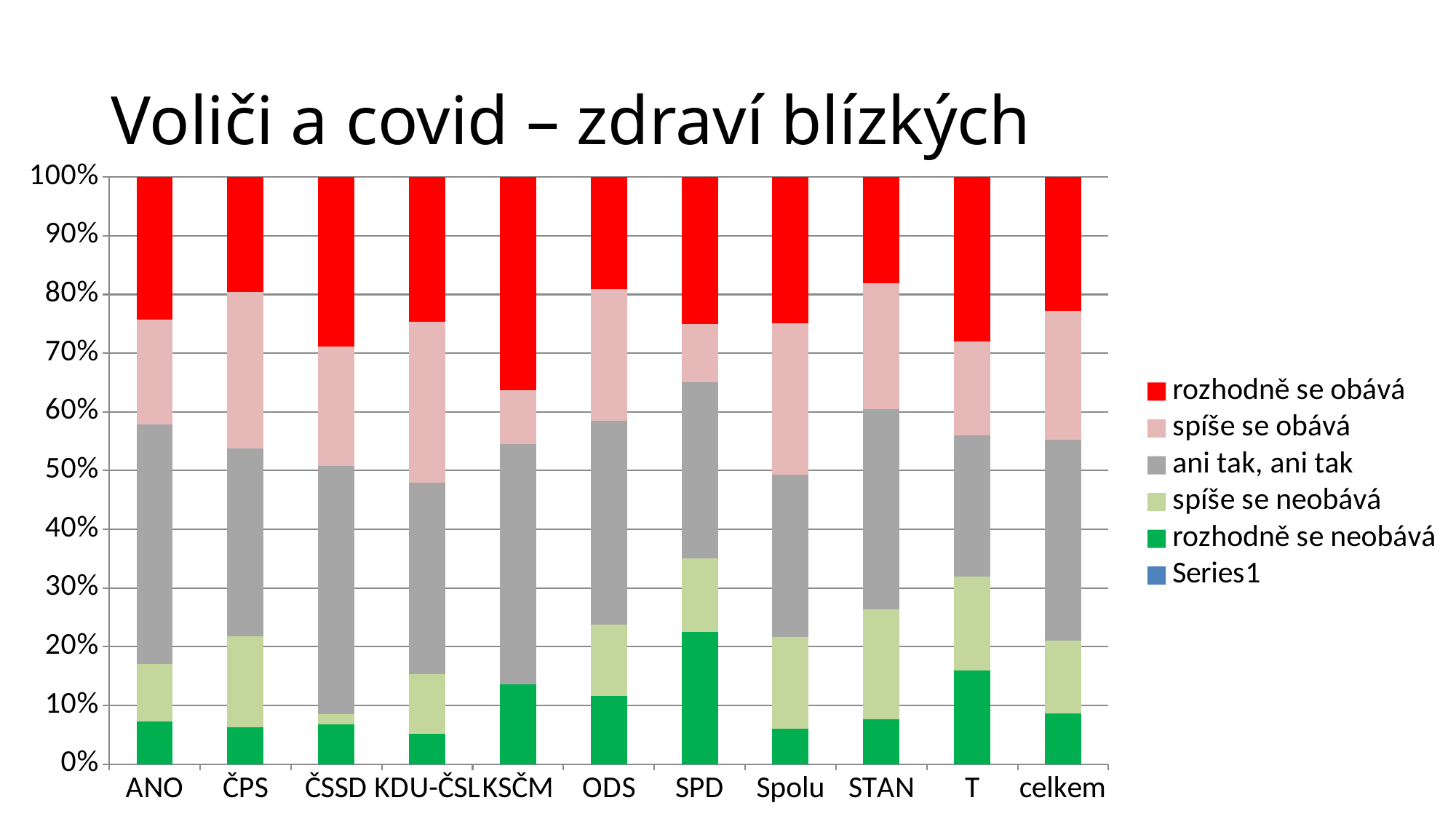
Which has a larger "rozhodně se neobává" share, SPD or ANO? SPD Is the "rozhodně se neobává" share for SPD greater or less than 20%? greater Is the "rozhodně se neobává" share for KSČM greater or less than 10%? greater How many series does the legend list? 6 Which has a larger "rozhodně se obává" share, KSČM or STAN? KSČM Is the "rozhodně se neobává" share for KDU-ČSL greater or less than 10%? less Which category has the largest "rozhodně se neobává" share? SPD Which category has the largest "rozhodně se obává" share? KSČM How many categories are shown on the x axis of the chart? 11 What is the title of the chart? Voliči a covid – zdraví blízkých Which colour represents "rozhodně se obává" in the chart? red What kind of chart is shown on the slide? stacked bar chart